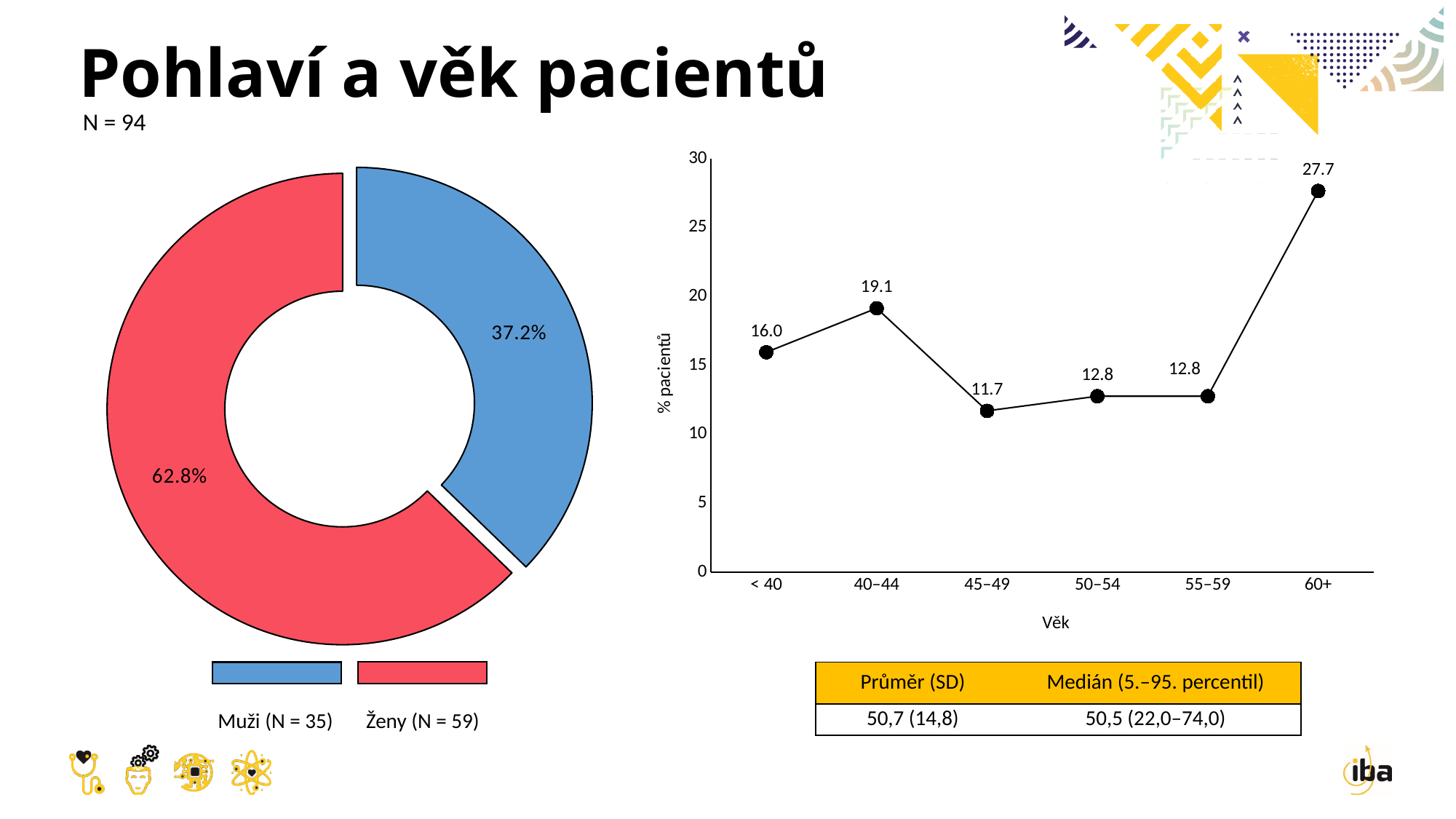
In the donut chart on the left, what is the difference in percentage points between the Ženy and Muži shares? 25.6 What type of chart is shown on the right side of the slide? Line chart In the donut chart on the left, which group is larger, Muži or Ženy? Ženy In the line chart on the right, how many age groups are plotted on the x axis? 6 In the donut chart on the left, what colour is the Muži segment? Blue In the line chart on the right, what is the difference between the values for 60+ and < 40? 11.7 In the line chart on the right, which age group has the highest % pacientů? 60+ In the line chart on the right, which age group has the lowest % pacientů? 45–49 In the donut chart on the left, what share of patients are men (Muži)? 37.2% In the donut chart on the left, how many categories does the legend list? 2 In the donut chart on the left, what share of patients are women (Ženy)? 62.8% In the line chart on the right, what is the value for the 40–44 age group? 19.1